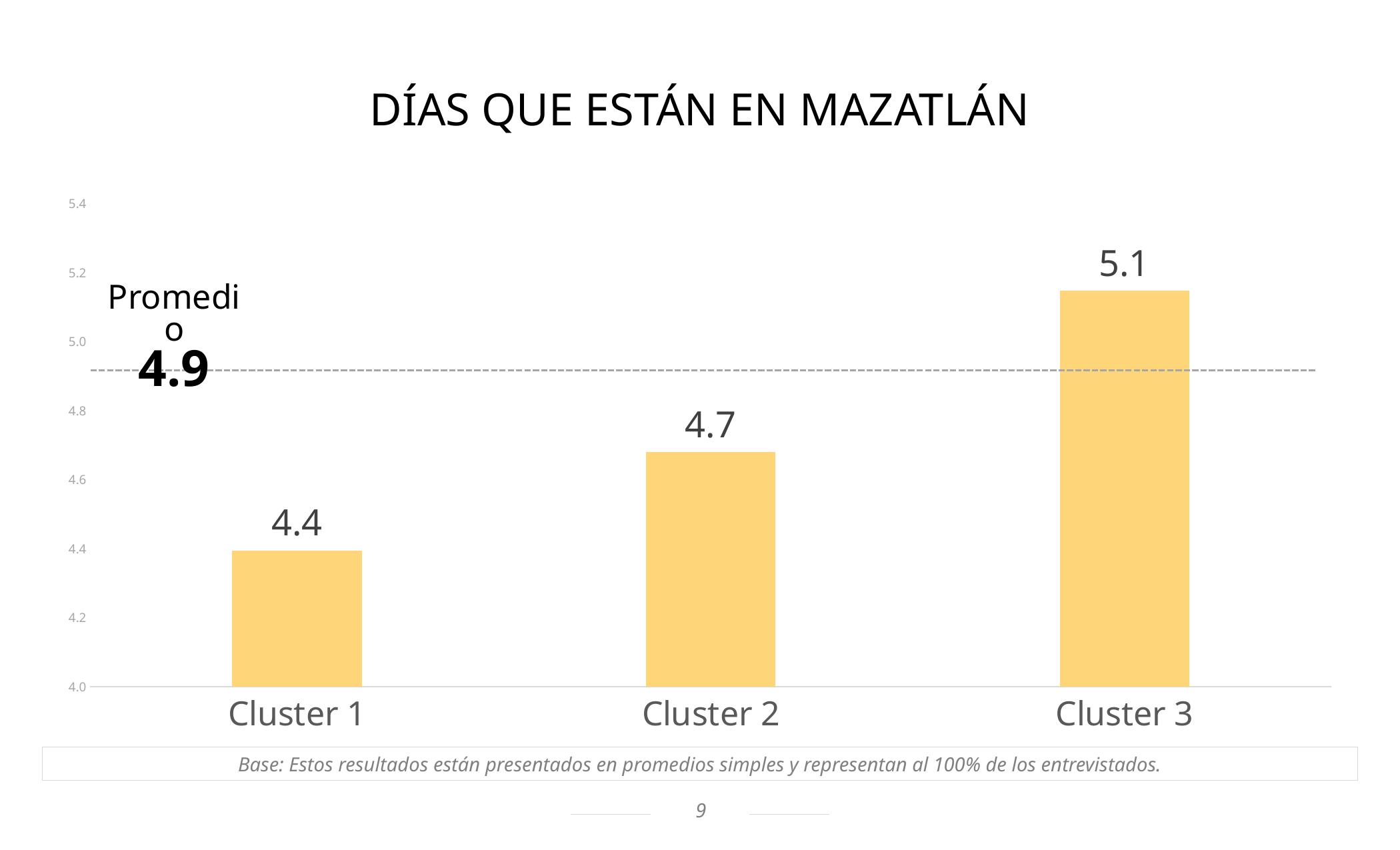
What kind of chart is shown on the slide? bar chart What is the difference between the values for Cluster 3 and Cluster 1? 0.7 How many clusters are shown in the chart? 3 Which is larger, the value for Cluster 2 or the value for Cluster 3? Cluster 3 What is the value for Cluster 3? 5.1 Which cluster has the highest value? Cluster 3 What is the difference between the values for Cluster 2 and Cluster 1? 0.3 Is the value for Cluster 3 greater or less than 5.0? greater What is the average (Promedio) value marked by the dashed line? 4.9 What is the value for Cluster 1? 4.4 What is the value for Cluster 2? 4.7 Which cluster has the lowest value? Cluster 1